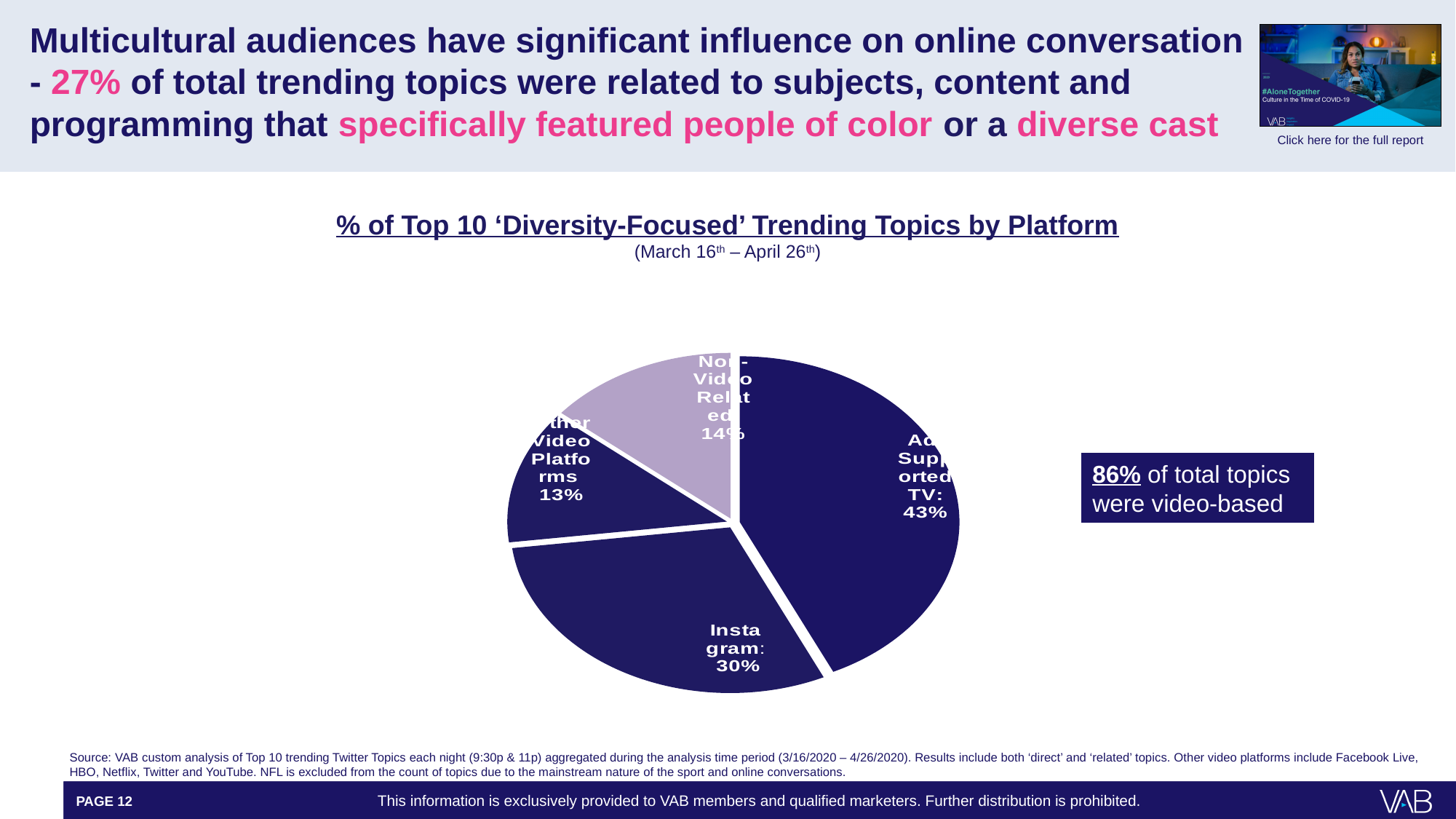
What is the title of the chart? % of Top 10 'Diversity-Focused' Trending Topics by Platform What is the difference in percentage points between Ad Supported TV and Instagram? 13 What kind of chart is shown on the slide? pie chart What date range is shown in the chart subtitle? March 16th – April 26th What share of the pie is Instagram? 30% Which slice of the pie is the smallest? Other Video Platforms Which is larger, the Instagram slice or the Non-Video Related slice? Instagram What share of the pie is Ad Supported TV? 43% Which slice of the pie is the largest? Ad Supported TV How many slices does the pie chart have? 4 What share of the pie is Non-Video Related? 14%